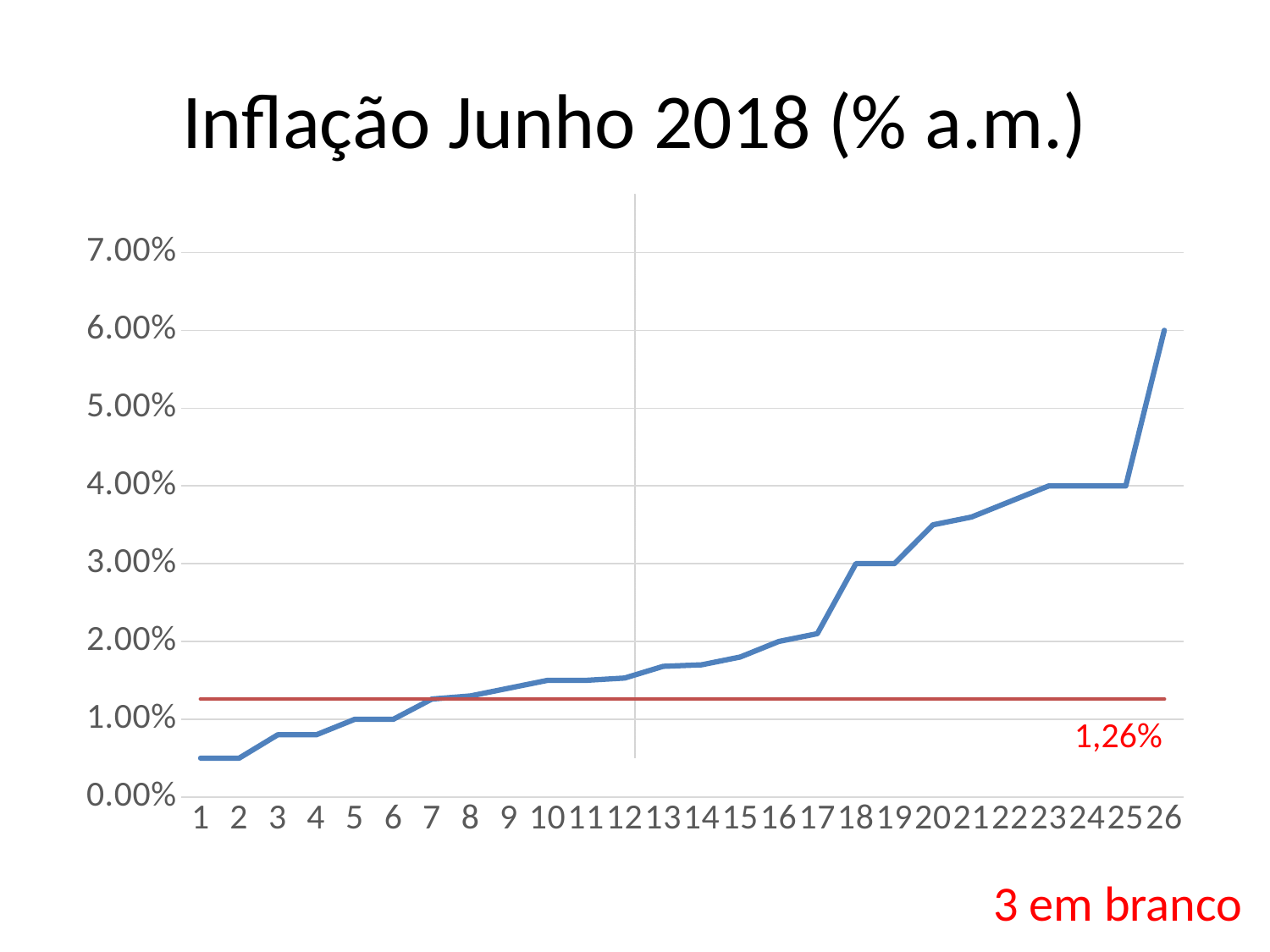
Do the values rise or fall from point 1 to point 26? rise What is the inflation value at point 18? 3.00% How many points are plotted along the x axis? 26 What is the title of the chart? Inflação Junho 2018 (% a.m.) Is the value at point 3 greater or less than 1.00%? less Is the value at point 17 greater or less than 3.00%? less What kind of chart is shown on the slide? line chart Which point has the highest inflation value? 26 Which is larger, the value at point 17 or the value at point 18? point 18 What value does the red horizontal line mark? 1,26% What is the inflation value at point 26? 6.00% What is the inflation value at point 23? 4.00%